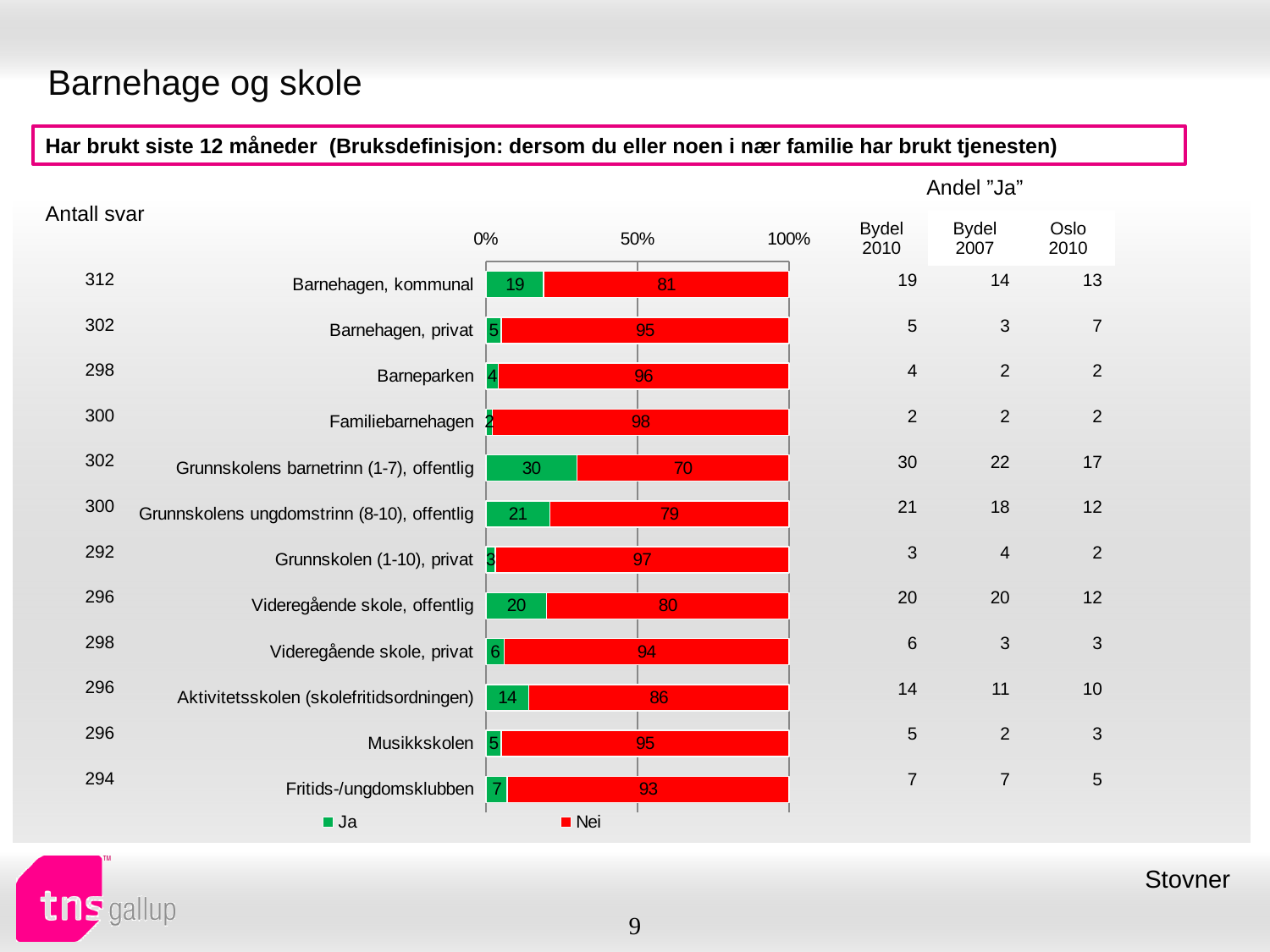
Which has a larger "Ja" value, Musikkskolen or Fritids-/ungdomsklubben? Fritids-/ungdomsklubben Which category has the lowest "Ja" value? Familiebarnehagen What is the "Nei" value for Aktivitetsskolen (skolefritidsordningen)? 86 What is the "Ja" value for Videregående skole, offentlig? 20 How many categories are shown in the chart? 12 What is the total of the stacked bar for Barneparken? 100 What is the difference between the "Nei" value for Familiebarnehagen and the "Nei" value for Grunnskolens barnetrinn (1-7), offentlig? 28 Which category has the highest "Ja" value? Grunnskolens barnetrinn (1-7), offentlig What kind of chart is shown on the slide? Stacked bar chart How many series does the legend list? 2 Is the "Nei" value for Grunnskolens ungdomstrinn (8-10), offentlig greater or less than 50%? greater What is the "Ja" value for Barnehagen, kommunal? 19